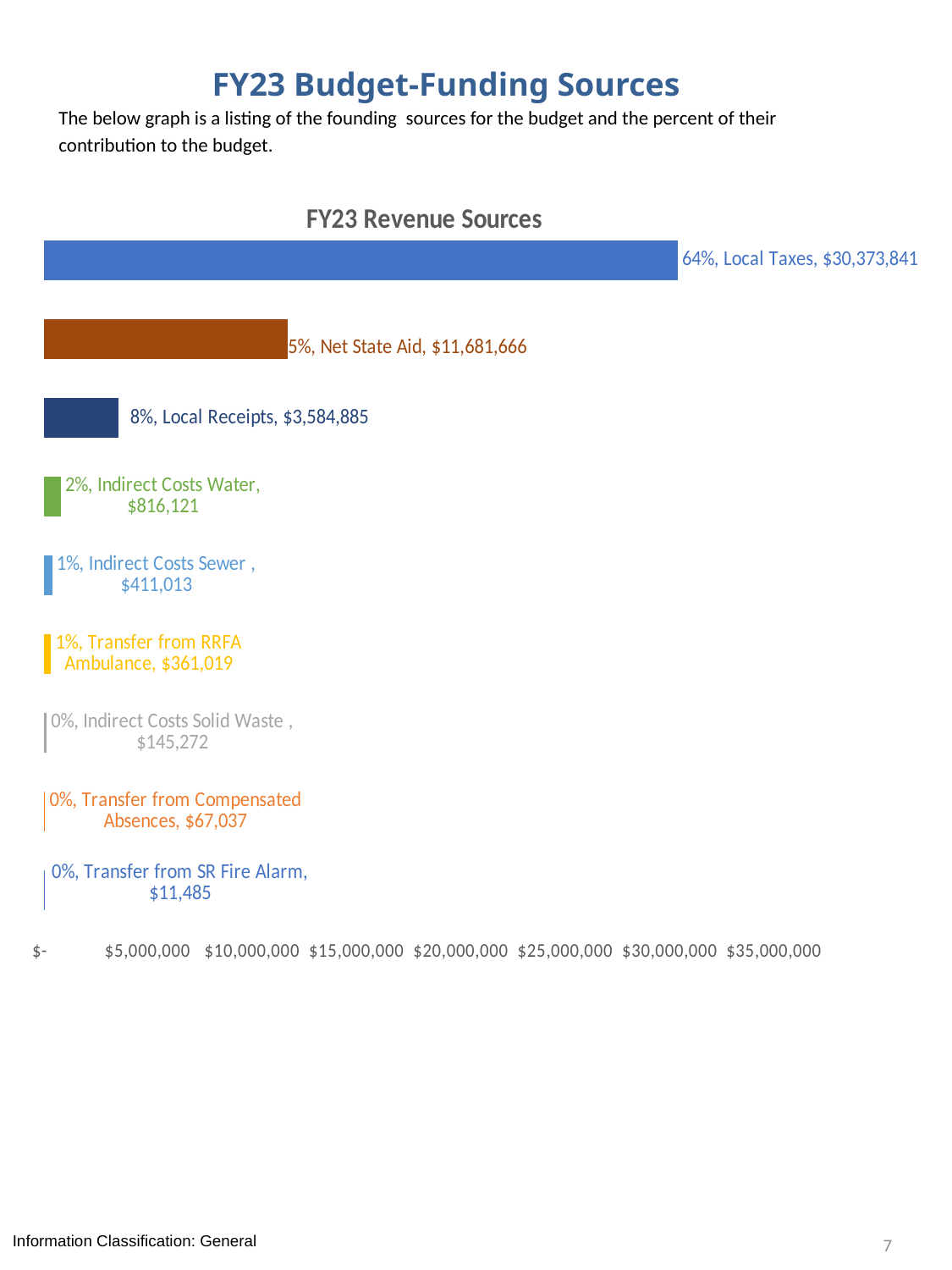
What is the title of the chart? FY23 Revenue Sources What is the dollar value for Net State Aid? $11,681,666 How many revenue sources are plotted in the chart? 9 Which revenue source has the highest value? Local Taxes What is the dollar value for Indirect Costs Water? $816,121 What is the dollar value for Transfer from SR Fire Alarm? $11,485 What is the dollar value for Local Taxes? $30,373,841 What type of chart is shown on the slide? bar chart What percent of the budget comes from Local Receipts? 8% Which revenue source has the lowest value? Transfer from SR Fire Alarm What is the difference between the Local Taxes value and the Net State Aid value? $18,692,175 Which is larger, Indirect Costs Sewer or Transfer from RRFA Ambulance? Indirect Costs Sewer